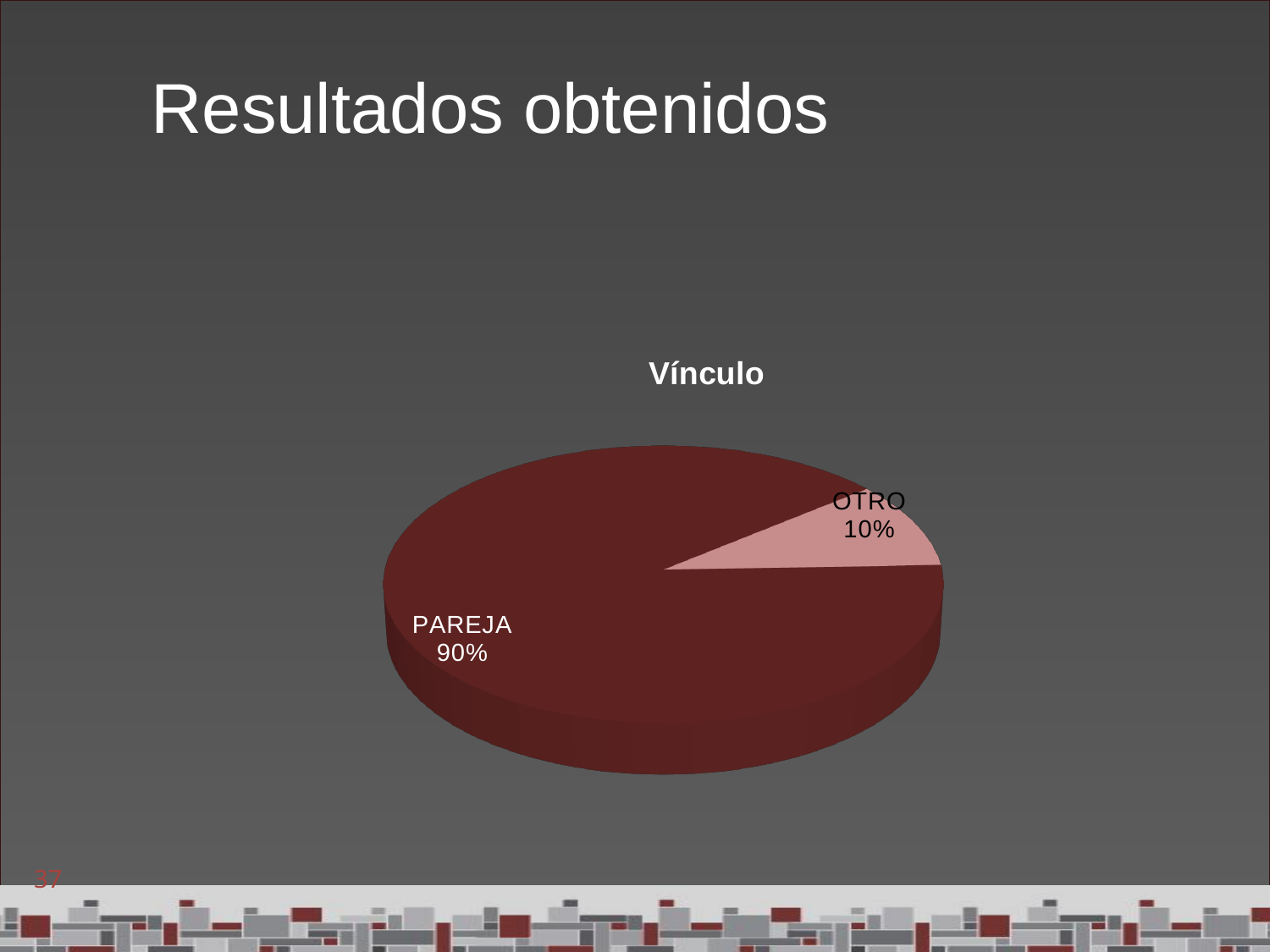
How many slices does the pie chart have? 2 What kind of chart is shown on the slide? pie chart Which category has the largest share of the pie? PAREJA Which category has the smallest share of the pie? OTRO What percentage does the PAREJA slice represent? 90% Which is larger, the share for PAREJA or the share for OTRO? PAREJA What is the difference in percentage points between PAREJA and OTRO? 80 What share of the pie does OTRO take? 10% What colour is the PAREJA slice? dark red What percentage does the OTRO slice represent? 10% What is the title of the chart? Vínculo